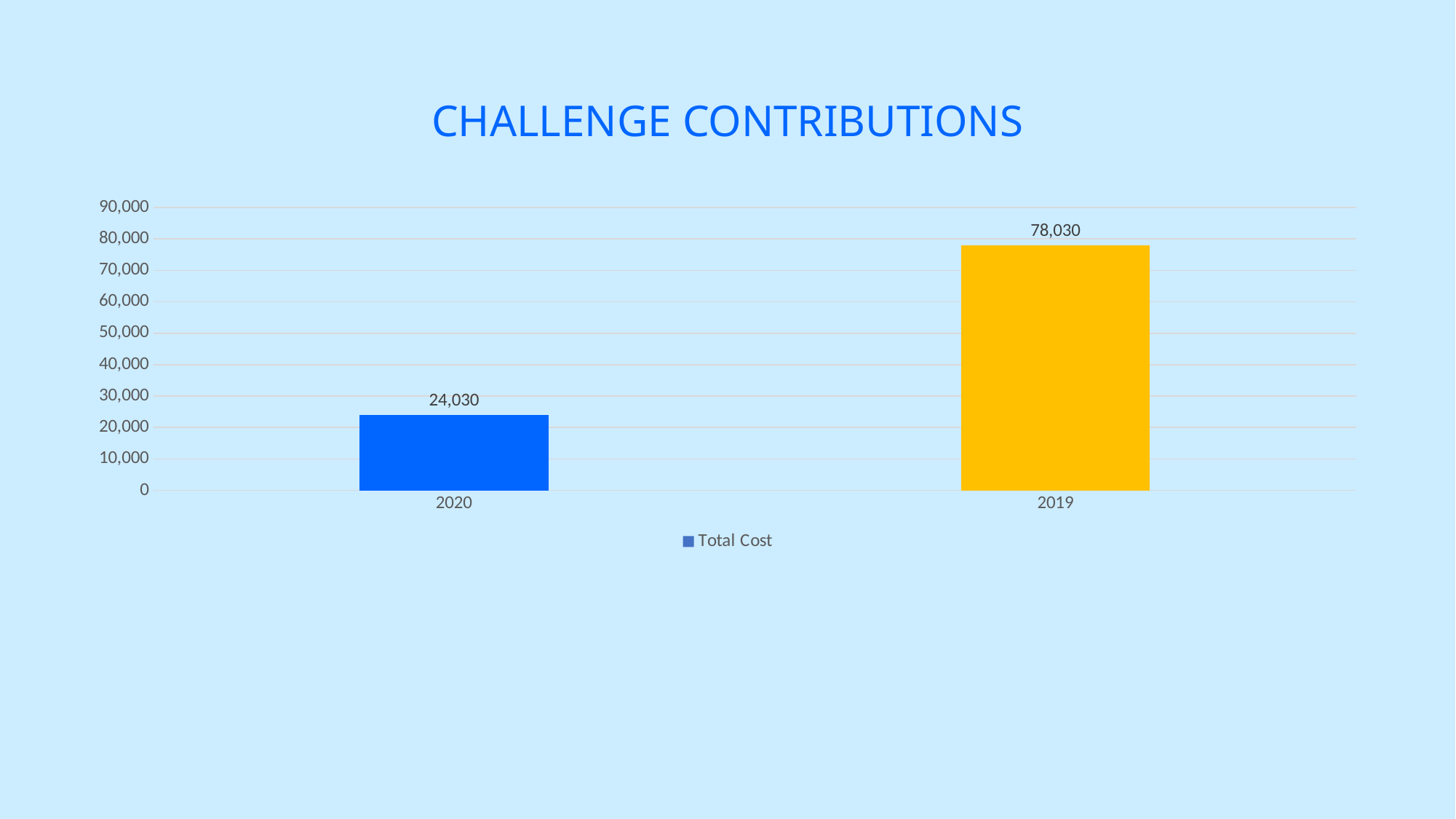
How many series does the legend list? 1 What kind of chart is shown on the slide? bar chart Which year has the highest Total Cost? 2019 What is the difference between the Total Cost for 2019 and 2020? 54,000 How many categories are shown on the x axis? 2 What is the title of the chart? CHALLENGE CONTRIBUTIONS Is the value for 2020 greater or less than 30,000? less What is the Total Cost value for 2019? 78,030 Which is larger, the Total Cost for 2020 or for 2019? 2019 What is the Total Cost value for 2020? 24,030 Which year has the lowest Total Cost? 2020 Is the value for 2019 greater or less than 70,000? greater